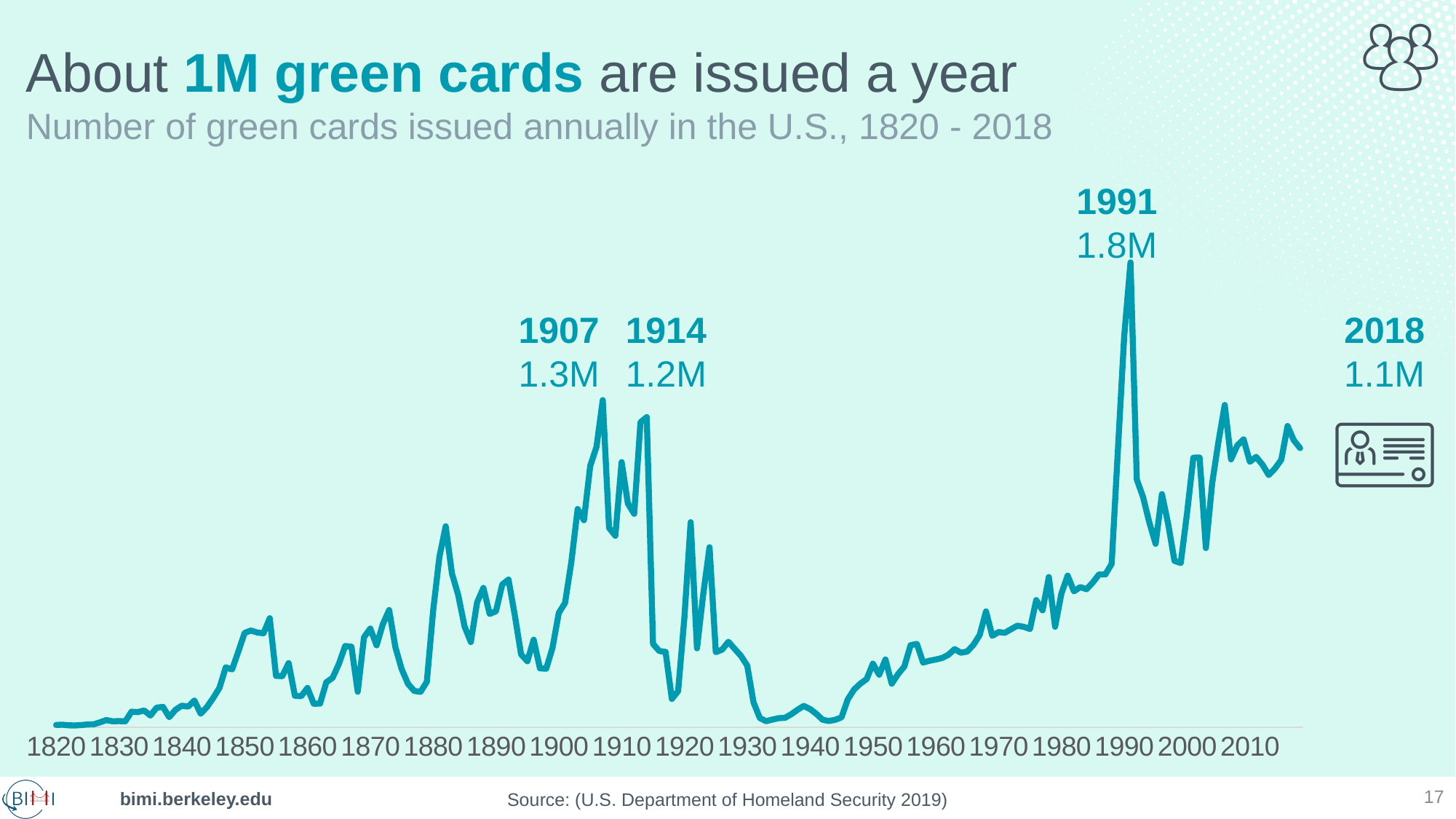
What is the difference between the labelled values for 1991 and 2018? 0.7M What value is labelled for the year 2018? 1.1M Which labelled year has the lowest number of green cards issued? 2018 What is the difference between the labelled values for 1907 and 1914? 0.1M What kind of chart is shown on the slide? Line chart What value is labelled for the year 1907? 1.3M Between 1930 and 1940, does the number of green cards issued rise or fall? Fall What value is labelled for the year 1914? 1.2M Which labelled year has the highest number of green cards issued? 1991 What is the subtitle describing the chart? Number of green cards issued annually in the U.S., 1820 - 2018 How many green cards were issued in 1991 according to the chart's label? 1.8M Which year had more green cards issued, 1907 or 1914? 1907